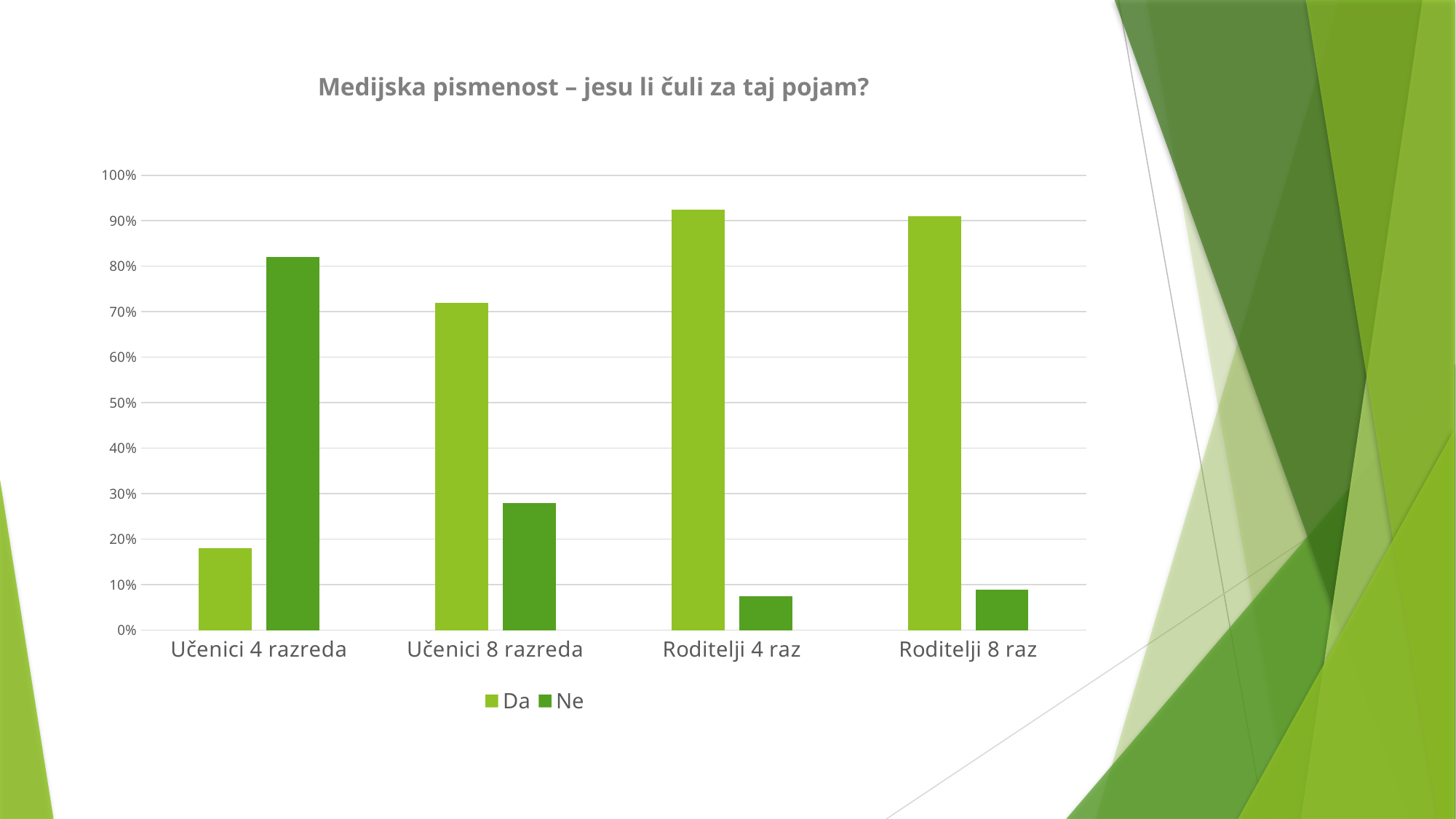
What is the title of the chart? Medijska pismenost – jesu li čuli za taj pojam? Is the Da value for Učenici 4 razreda greater or less than 20%? less Which category has the highest value for the Ne series? Učenici 4 razreda Is the Ne value for Roditelji 4 raz greater or less than 10%? less For Učenici 8 razreda, which is larger: the Da value or the Ne value? Da Is the Ne value for Učenici 4 razreda greater or less than 80%? greater How many series does the legend list? 2 What kind of chart is shown on the slide? bar chart Which category has the lowest value for the Da series? Učenici 4 razreda How many categories are shown on the x axis? 4